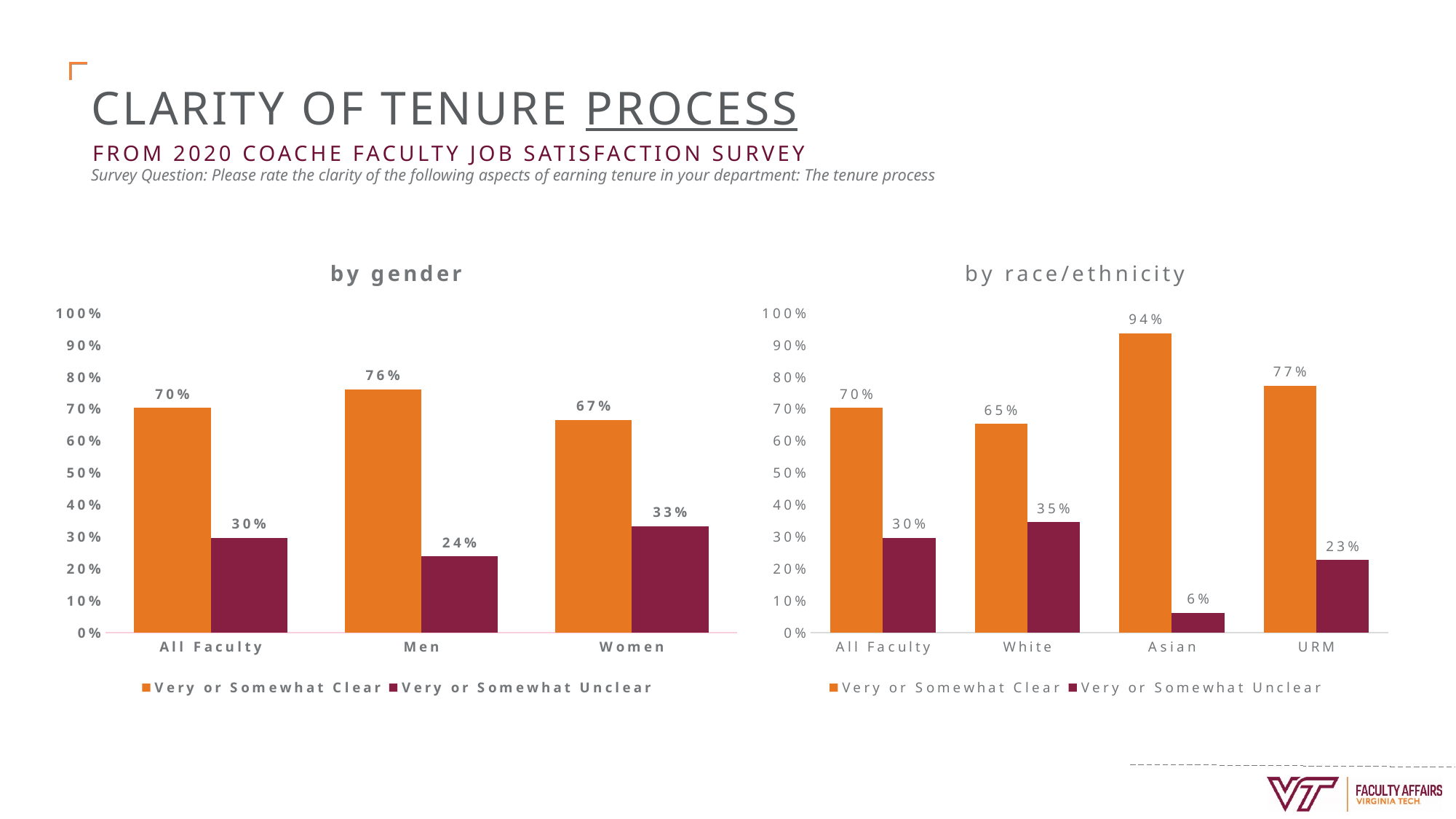
In the 'by gender' chart, what is the value for Women in the 'Very or Somewhat Unclear' series? 33% In the 'by gender' chart, what is the value for Men in the 'Very or Somewhat Clear' series? 76% In the 'by race/ethnicity' chart, which category has the highest 'Very or Somewhat Clear' value? Asian In the 'by race/ethnicity' chart, what is the value for URM in the 'Very or Somewhat Unclear' series? 23% In the 'by race/ethnicity' chart, which category has the lowest 'Very or Somewhat Unclear' value? Asian How many series does the legend of the 'by gender' chart list? 2 In the 'by race/ethnicity' chart, what is the difference between the 'Very or Somewhat Clear' values for Asian and White? 29% In the 'by race/ethnicity' chart, what is the value for Asian in the 'Very or Somewhat Clear' series? 94% How many categories are shown on the x axis of the 'by race/ethnicity' chart? 4 In the 'by gender' chart, what is the difference between the 'Very or Somewhat Clear' values for Men and Women? 9% In the 'by race/ethnicity' chart, which is larger: the 'Very or Somewhat Unclear' value for White or for All Faculty? White What kind of chart is the 'by gender' chart? Bar chart